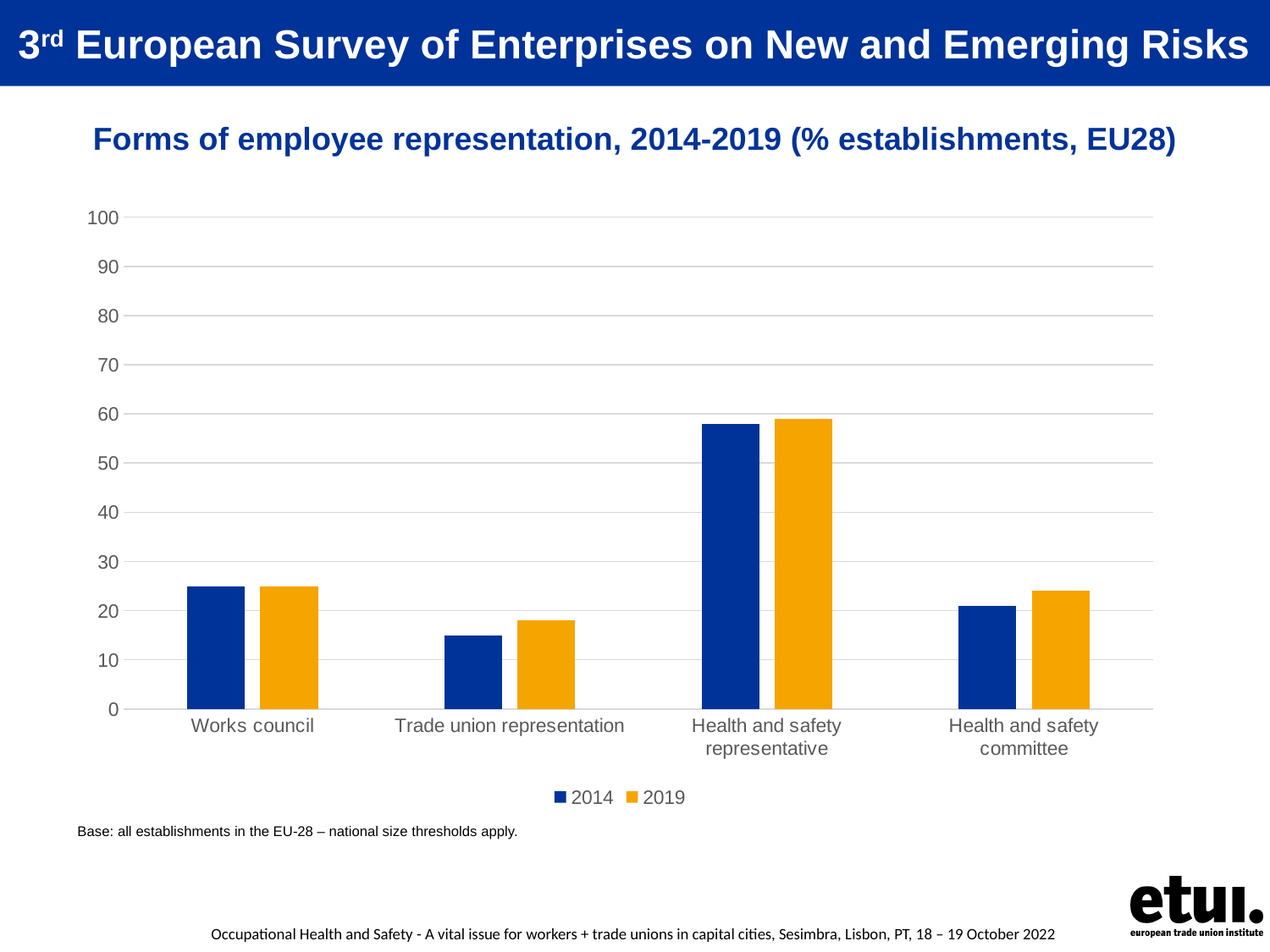
For 2014, which is larger: Works council or Health and safety committee? Works council For Trade union representation, which year has the larger value, 2014 or 2019? 2019 What is the title of the chart? Forms of employee representation, 2014-2019 (% establishments, EU28) Is the 2014 value for Health and safety representative greater or less than 50? greater How many categories are shown on the x axis of the chart? 4 What kind of chart is shown on the slide? bar chart Which category has the lowest value for 2014? Trade union representation How many series does the legend list? 2 Is the 2019 value for Health and safety committee greater or less than 30? less Is the 2014 value for Trade union representation greater or less than 20? less Which category has the highest value for 2019? Health and safety representative